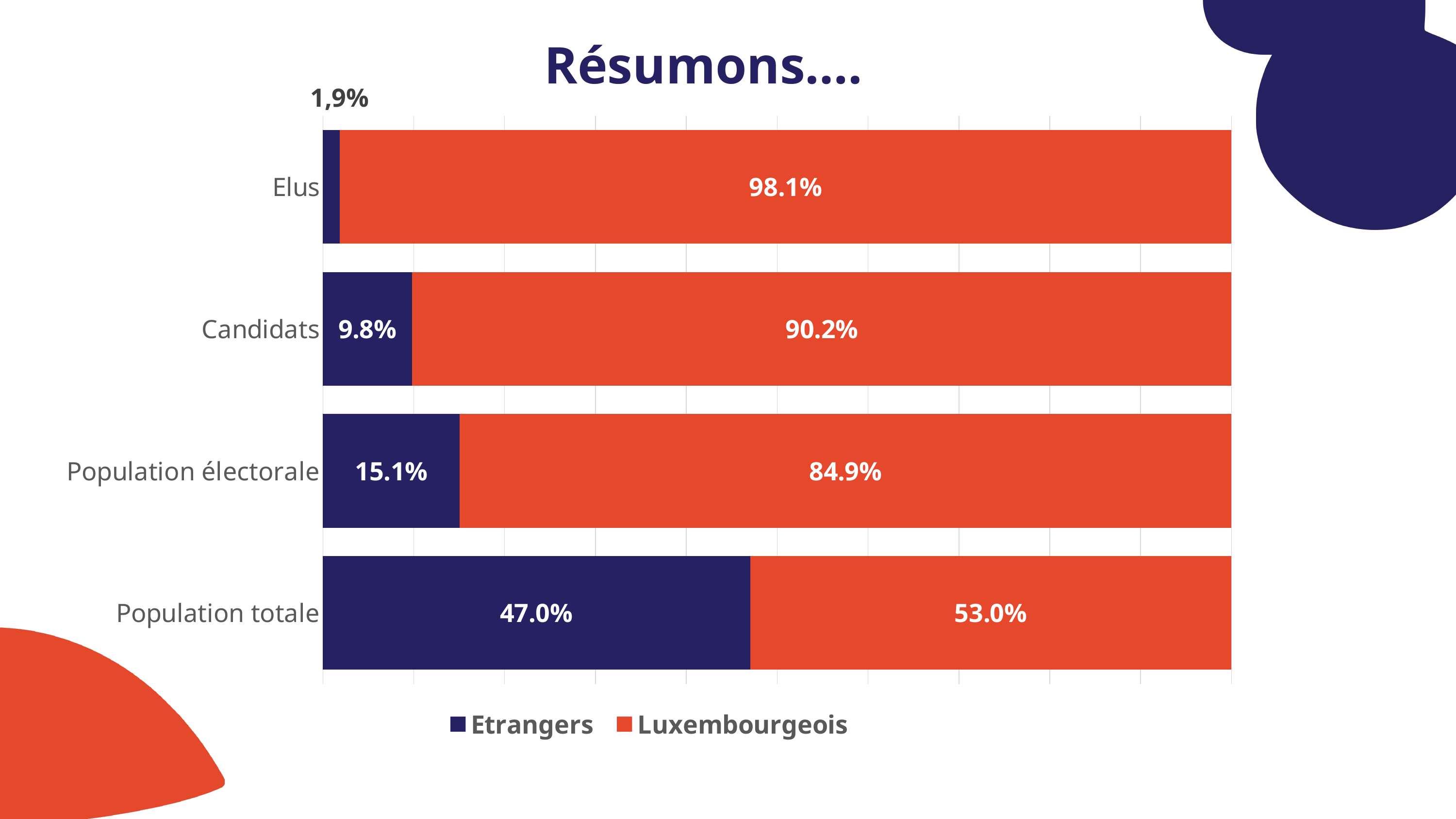
What is the value for Luxembourgeois in the Population électorale category? 84.9% Which is larger: the Etrangers value for Population électorale or for Candidats? Population électorale What is the title of the slide? Résumons.... What is the value for Etrangers in the Candidats category? 9.8% How many series does the legend list? 2 What kind of chart is shown on the slide? Stacked bar chart Which category has the highest value for Etrangers? Population totale What is the value for Etrangers in the Population totale category? 47.0% How many categories are shown on the chart? 4 What is the value for Luxembourgeois in the Elus category? 98.1% What is the difference between the Luxembourgeois values for Elus and Candidats? 7.9% Which category has the lowest value for Luxembourgeois? Population totale